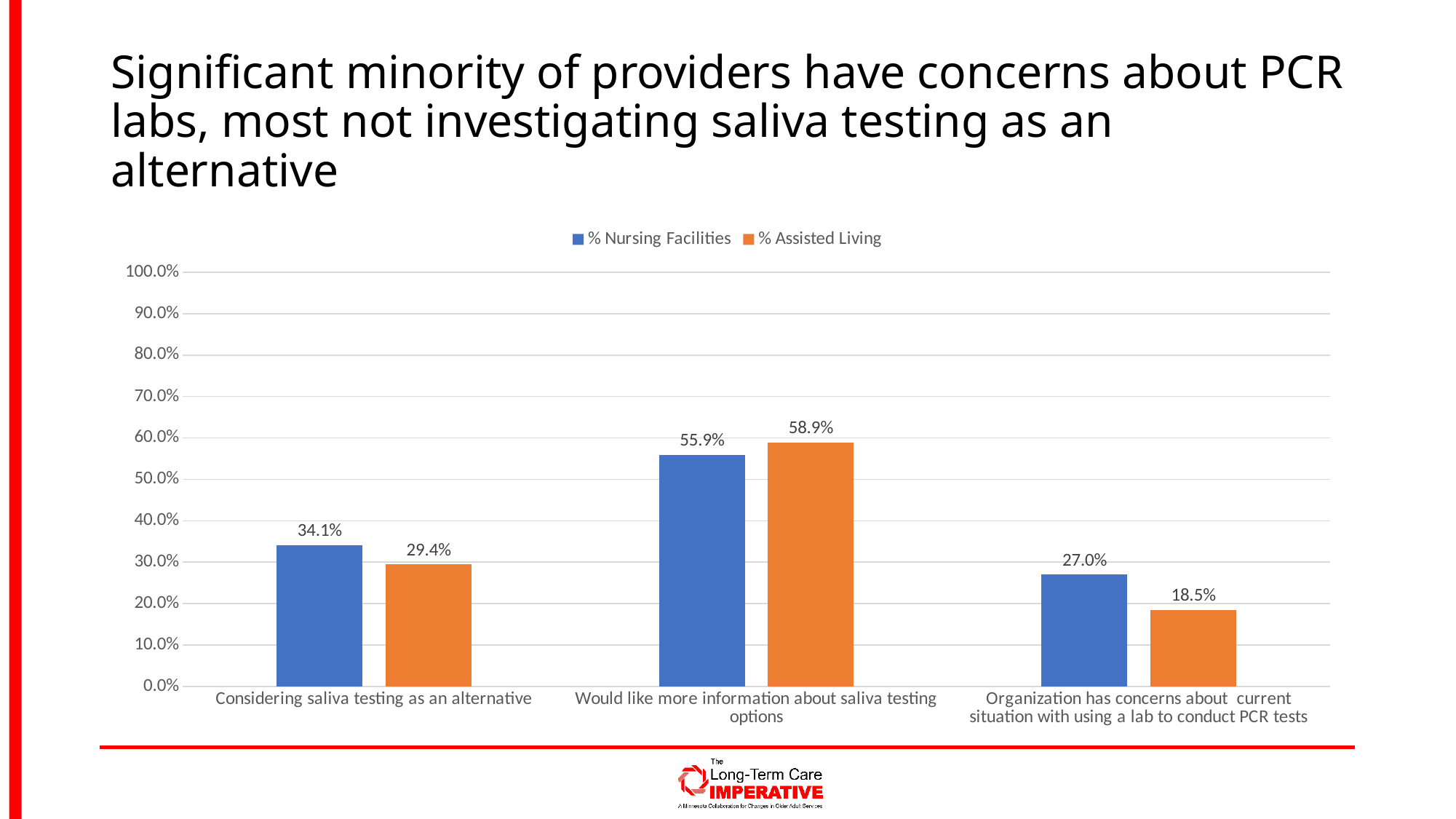
How many series does the legend list? 2 Which category has the highest % Nursing Facilities value? Would like more information about saliva testing options What is the difference between the % Nursing Facilities and % Assisted Living values for "Considering saliva testing as an alternative"? 4.7% What kind of chart is shown on the slide? Bar chart For "Would like more information about saliva testing options", which is larger: % Nursing Facilities or % Assisted Living? % Assisted Living What colour are the % Assisted Living bars? Orange Which category has the lowest % Assisted Living value? Organization has concerns about current situation with using a lab to conduct PCR tests What is the % Nursing Facilities value for "Considering saliva testing as an alternative"? 34.1% Is the % Nursing Facilities value for "Organization has concerns about current situation with using a lab to conduct PCR tests" greater or less than 30.0%? less What is the % Assisted Living value for "Would like more information about saliva testing options"? 58.9% How many categories are shown on the x axis? 3 What is the % Assisted Living value for "Organization has concerns about current situation with using a lab to conduct PCR tests"? 18.5%